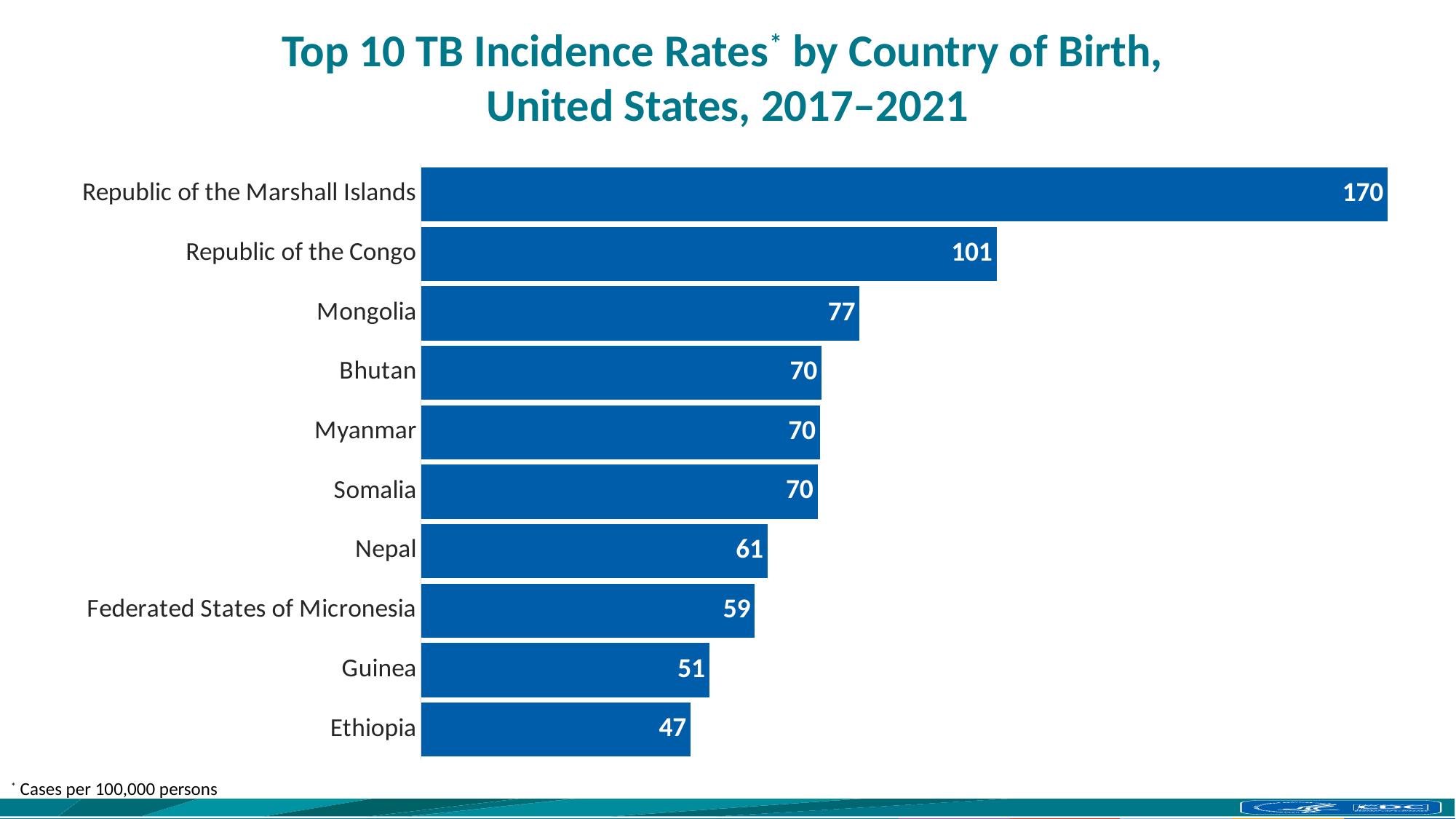
According to the footnote, in what units are the TB incidence rates expressed? Cases per 100,000 persons What is the TB incidence rate for Mongolia? 77 Which country of birth has the lowest TB incidence rate shown? Ethiopia Which country of birth has the highest TB incidence rate? Republic of the Marshall Islands How many countries are shown in the chart? 10 Which has a higher TB incidence rate, Mongolia or Bhutan? Mongolia What is the difference between the TB incidence rates for the Republic of the Marshall Islands and the Republic of the Congo? 69 What is the TB incidence rate for Nepal? 61 What is the TB incidence rate for the Federated States of Micronesia? 59 What is the difference between the TB incidence rates for Guinea and Ethiopia? 4 What kind of chart is shown on the slide? Bar chart How many countries share a TB incidence rate of 70? 3